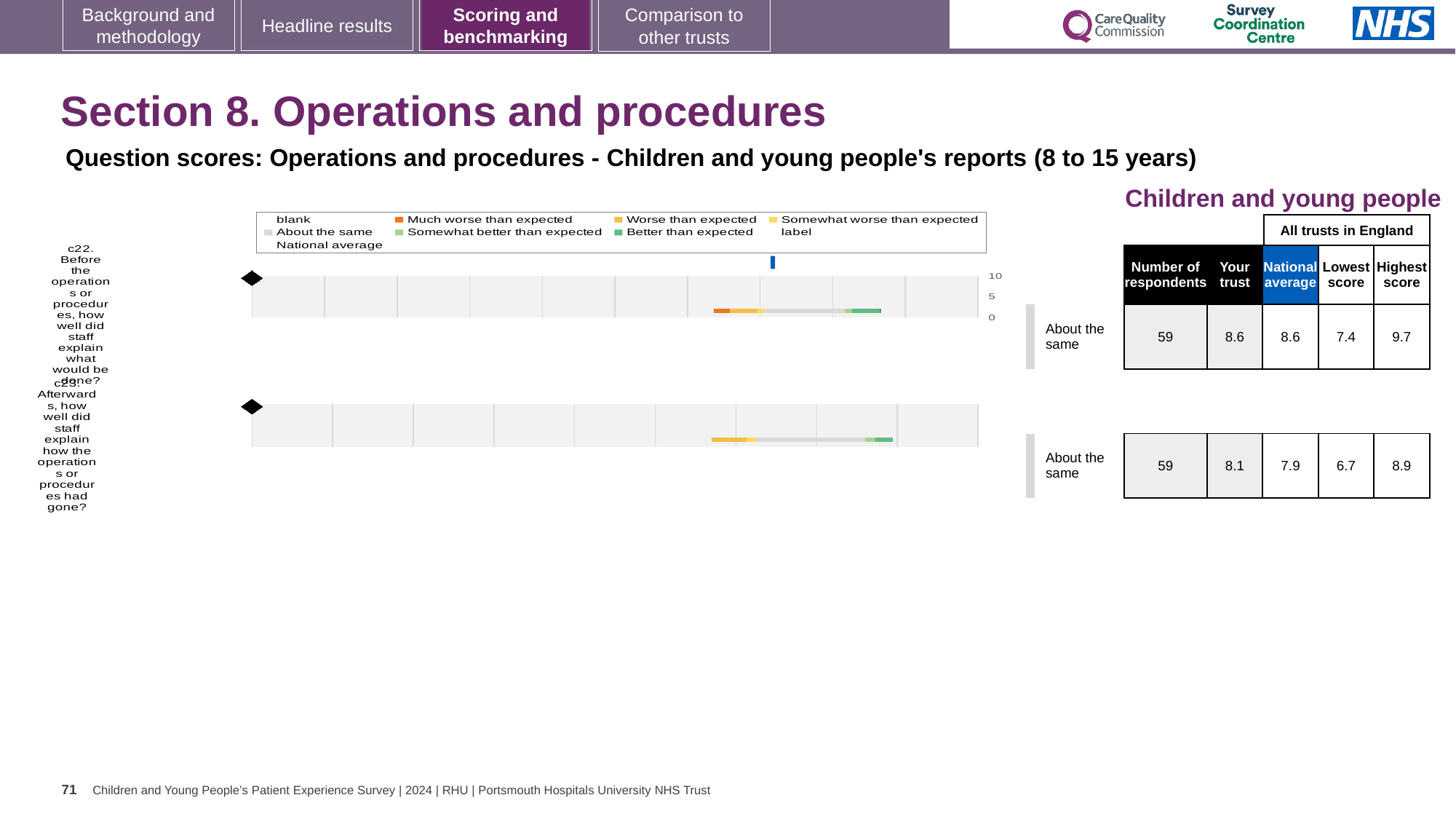
For c22, what is the difference between the highest score and the lowest score? 2.3 What is the highest score among all trusts in England for c23? 8.9 What kind of chart is used to show the benchmark for question c22? bar chart For c23, what is the difference between the highest score and the lowest score? 2.2 What is the lowest score among all trusts in England for c22? 7.4 What is the national average score for c23 (Afterwards, how well did staff explain how the operations or procedures had gone?)? 7.9 How many respondents answered question c22? 59 What is the 'Your trust' score for c22 (Before the operations or procedures, how well did staff explain what would be done?)? 8.6 What benchmark category is shown next to the c22 chart? About the same How many question charts are shown on the slide? 2 What colour does the legend use for 'Much worse than expected'? orange For c23, which is larger: the 'Your trust' score or the national average? Your trust